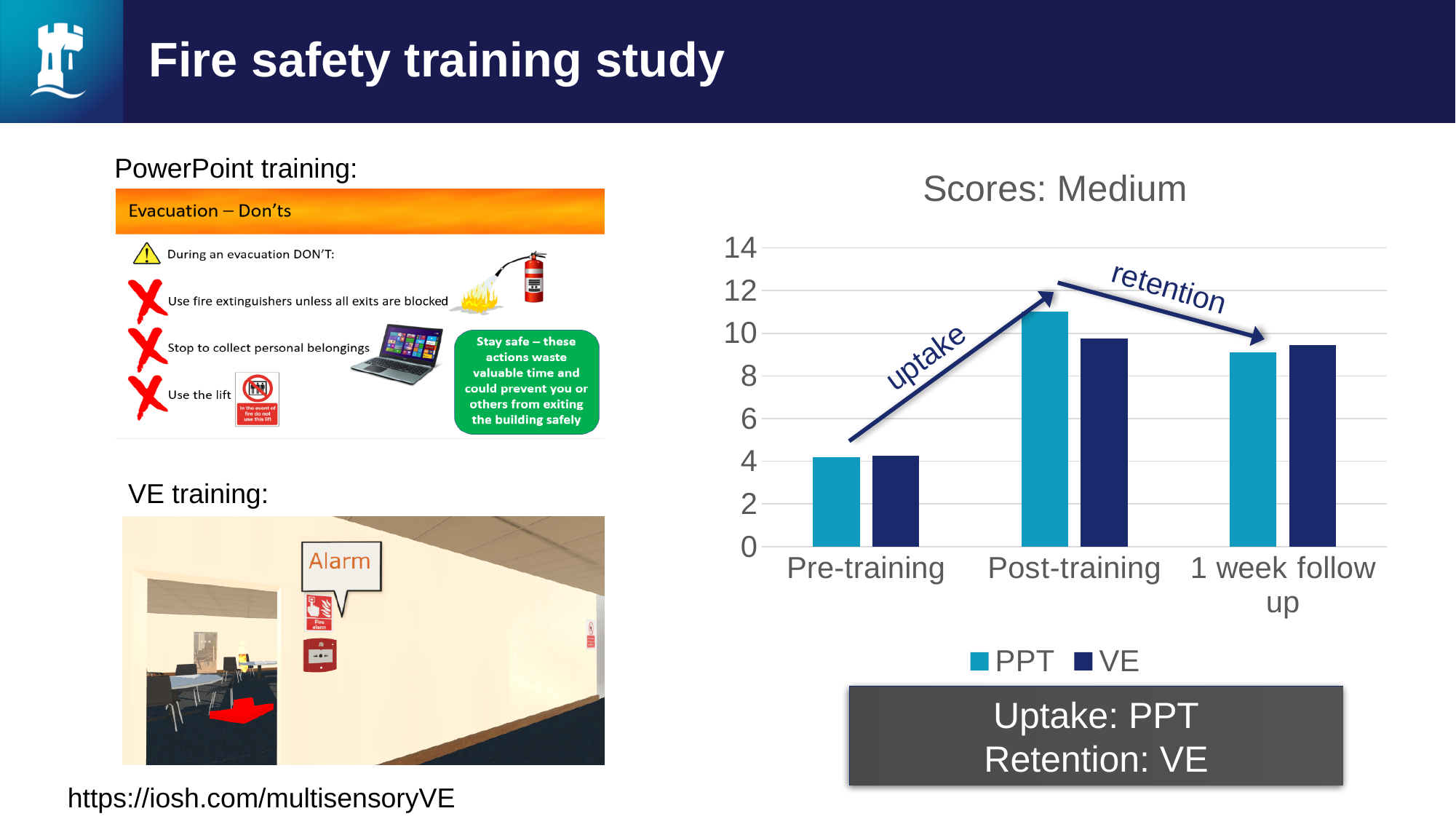
Is the PPT score at 1 week follow up greater or less than 10? less How many categories are shown on the x axis of the chart? 3 At which category is the PPT score highest? Post-training Is the PPT score at Post-training greater or less than 10? greater How many series does the chart legend list? 2 Which two series are listed in the chart legend? PPT and VE How does the PPT score change from Pre-training to Post-training to 1 week follow up? rises then falls What is the title of the chart? Scores: Medium What type of chart is shown on the slide? bar chart At Post-training, which series has the higher score, PPT or VE? PPT Is the PPT score at Pre-training greater or less than 6? less At which category is the VE score lowest? Pre-training